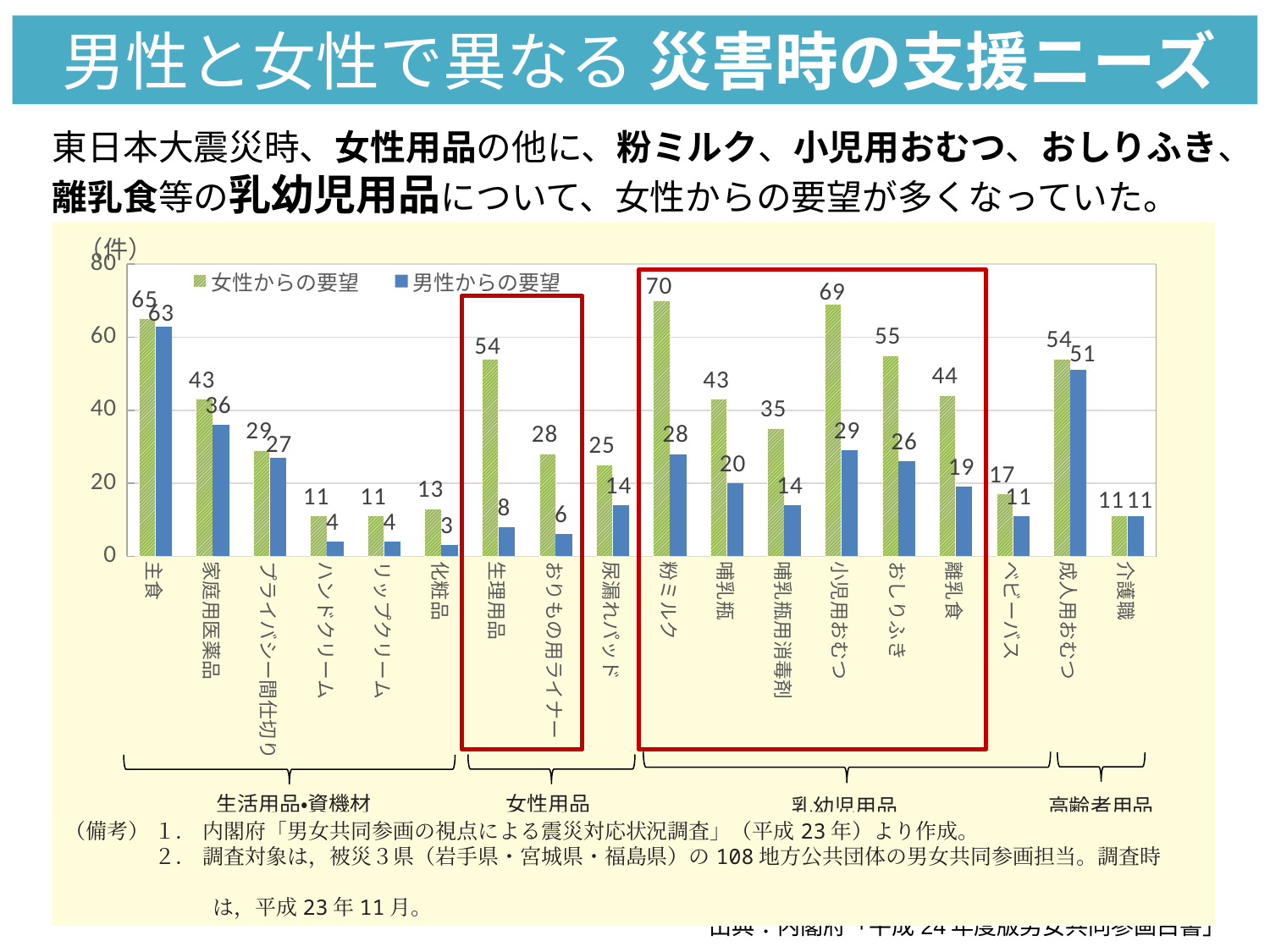
What unit is shown at the top of the y axis? (件) What type of chart is shown on the slide? bar chart What is the difference between 女性からの要望 and 男性からの要望 for 生理用品? 46 How many series does the legend list? 2 Which category has the highest value for 男性からの要望? 主食 What is the value of 女性からの要望 for 小児用おむつ? 69 Which is larger for 成人用おむつ: 女性からの要望 or 男性からの要望? 女性からの要望 What is the value of 男性からの要望 for 生理用品? 8 Which category has the lowest value for 男性からの要望? 化粧品 Which category has the highest value for 女性からの要望? 粉ミルク How many categories are shown on the x axis? 18 What is the value of 女性からの要望 for 粉ミルク? 70